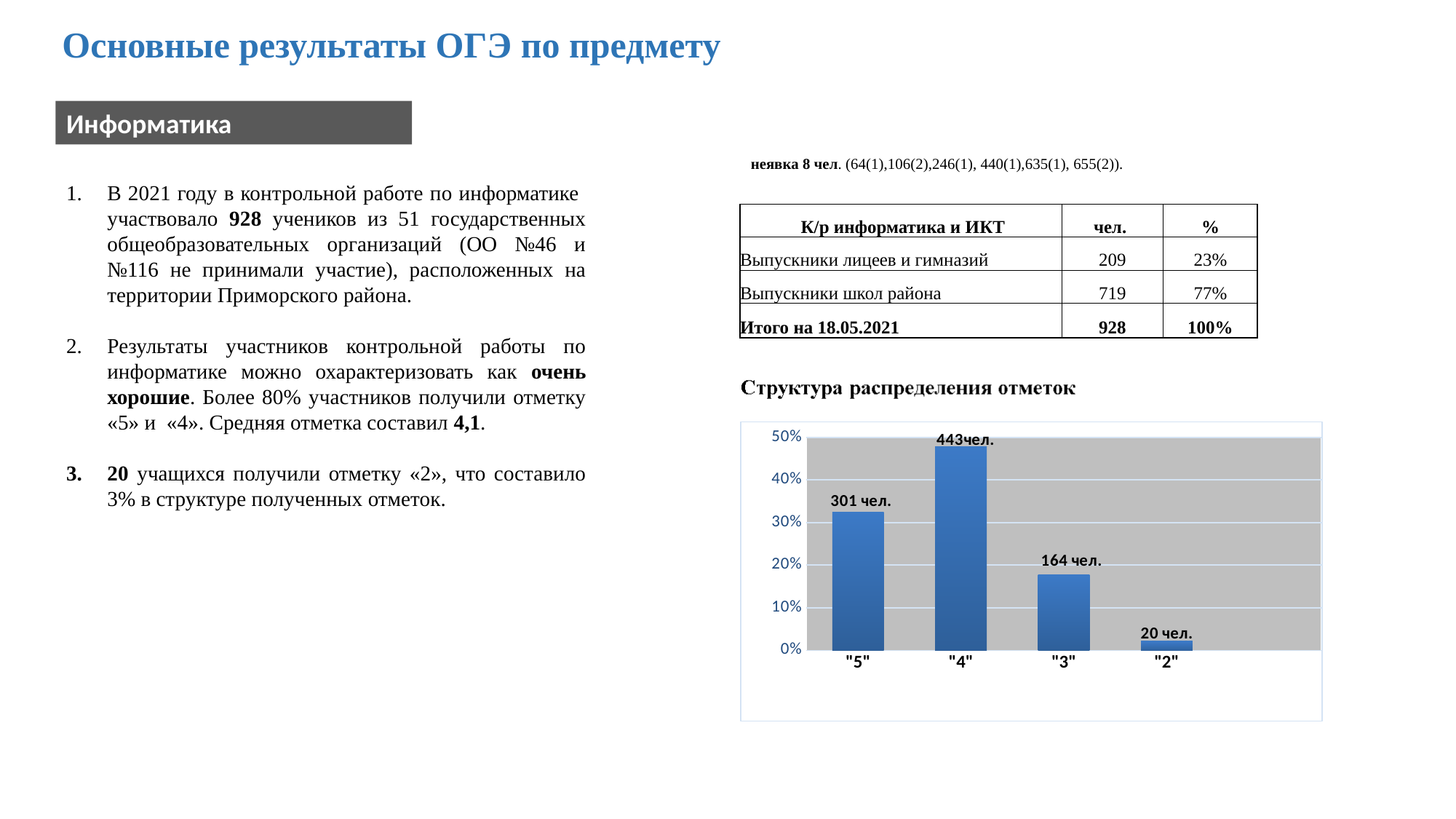
How many people received the mark "2" according to the chart? 20 чел. How many categories (marks) are shown on the x axis of the chart? 4 What type of chart is used to show the distribution of marks? Bar chart What is the data label on the bar for "4" in the chart "Структура распределения отметок"? 443чел. Is the value for "3" greater or less than 20%? less Is the value for "4" greater or less than 40%? greater How many people received the mark "5" according to the chart? 301 чел. Which bar is taller: "5" or "3"? "5" Which mark has the tallest bar in the chart? "4" By how many people does the count for mark "4" exceed the count for mark "5"? 142 How many people received the mark "3" according to the chart? 164 чел. Which mark has the shortest bar in the chart? "2"